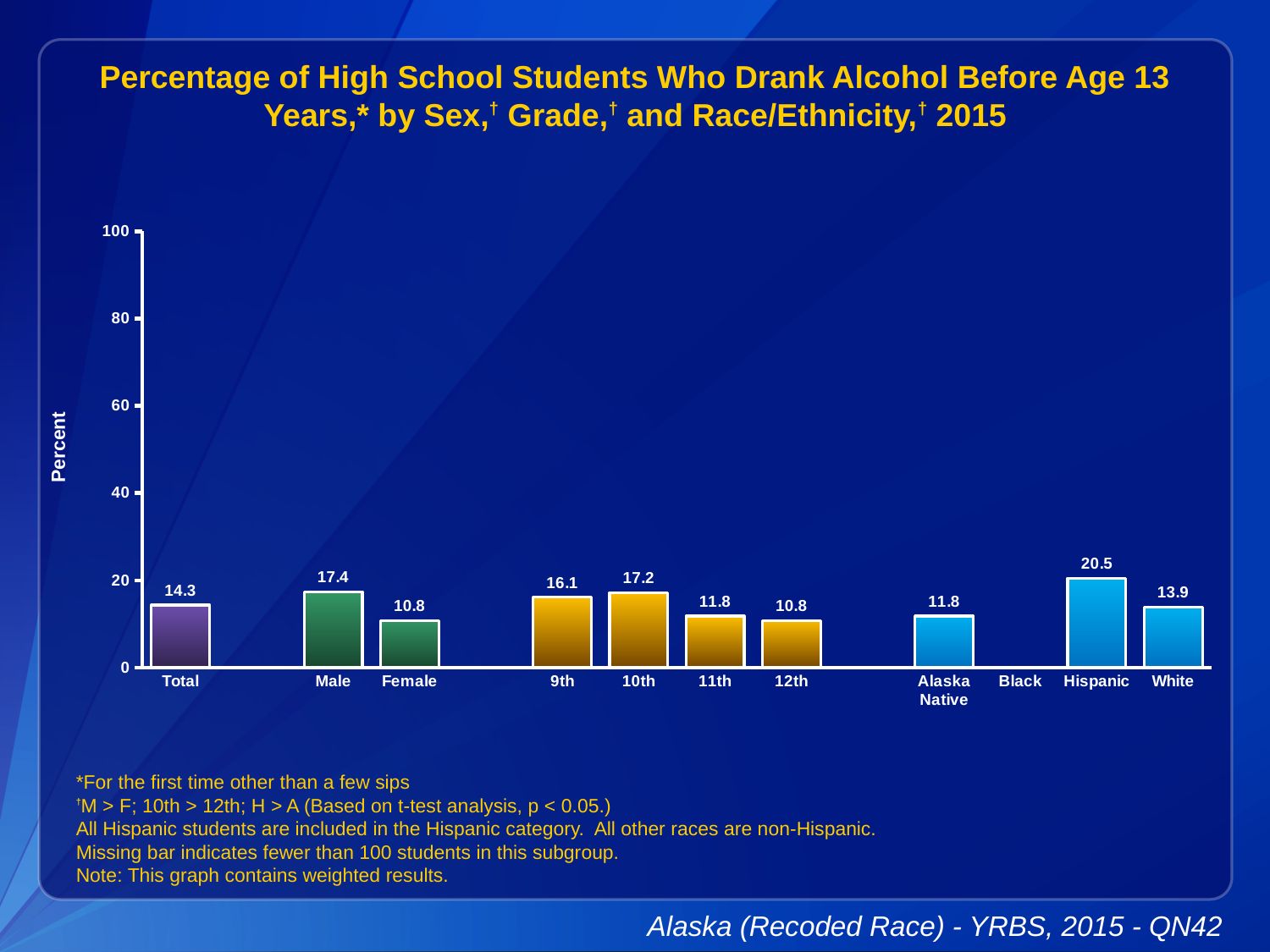
Which category has the highest value? Hispanic Which category has no bar shown? Black What is the value for Female? 10.8 Is the value for Hispanic greater or less than 20? greater Which is larger, the value for 9th grade or the value for 11th grade? 9th What is the value for 10th grade? 17.2 What is the difference between the values for Male and Female? 6.6 What is the value for Total? 14.3 What is the value for Hispanic? 20.5 What is the difference between the values for 10th and 12th grade? 6.4 What kind of chart is shown? bar chart